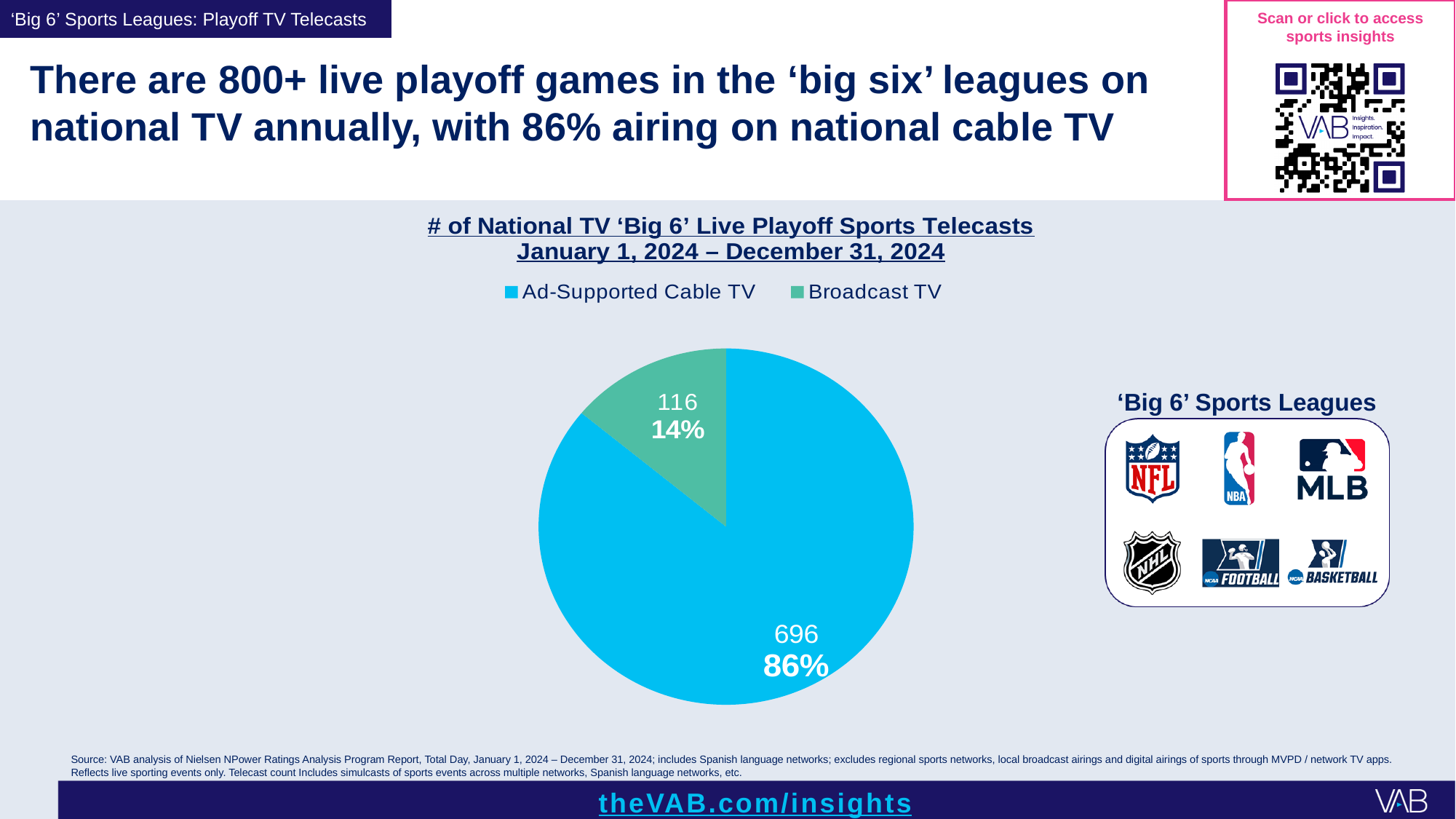
What is the total number of telecasts shown in the pie chart? 812 What share of the pie does Broadcast TV represent? 14% Which category has the smallest slice of the pie? Broadcast TV How many live playoff telecasts aired on Broadcast TV? 116 Which category has the largest slice of the pie? Ad-Supported Cable TV What date range does the chart title cover? January 1, 2024 – December 31, 2024 Which is larger, the number of telecasts on Broadcast TV or on Ad-Supported Cable TV? Ad-Supported Cable TV How many series does the legend list? 2 What is the difference in telecasts between Ad-Supported Cable TV and Broadcast TV? 580 What share of the pie does Ad-Supported Cable TV represent? 86% What type of chart is shown on the slide? Pie chart How many live playoff telecasts aired on Ad-Supported Cable TV? 696